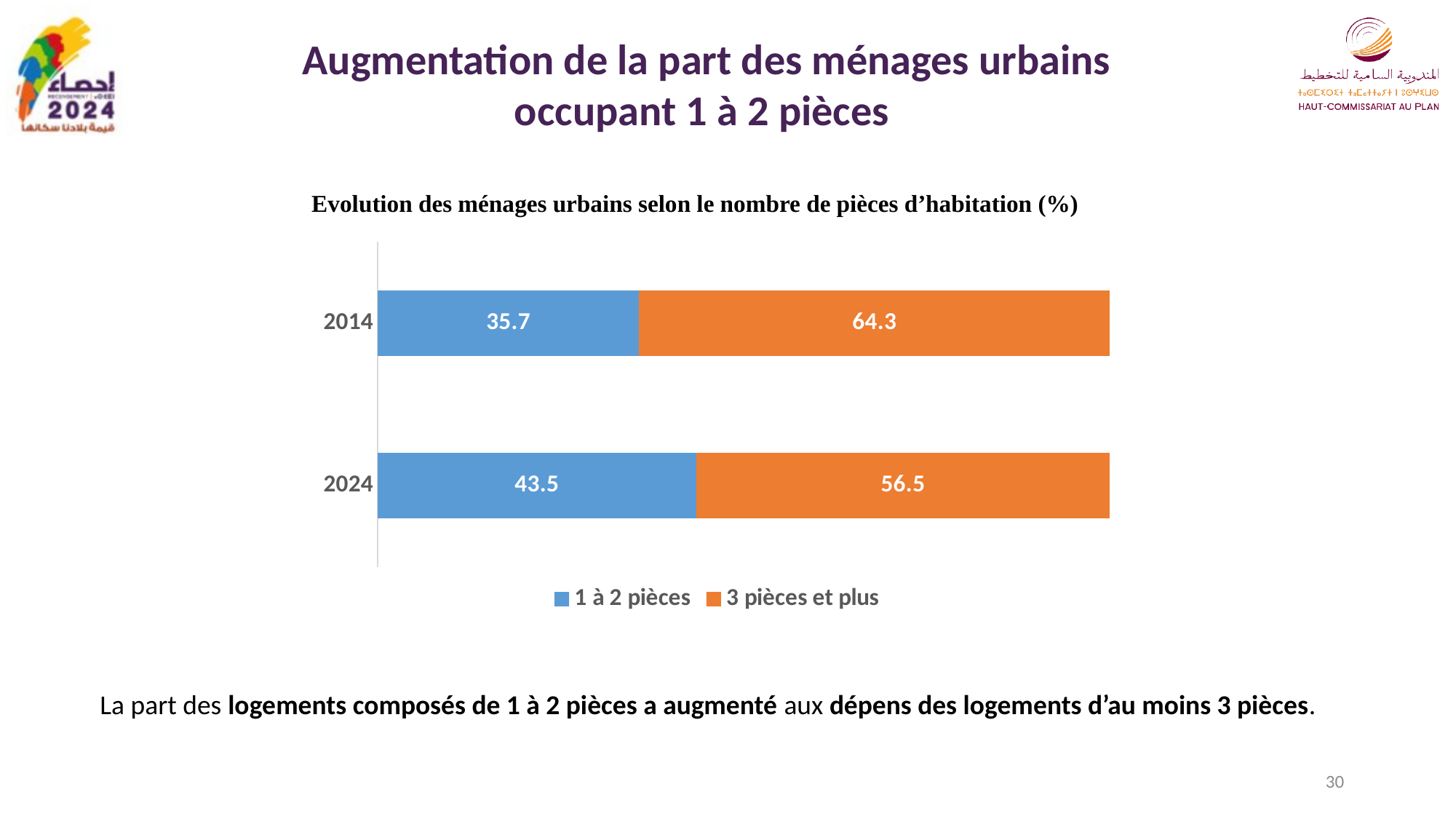
What kind of chart is shown on the slide? Stacked bar chart In which year is the value for '3 pièces et plus' higher, 2014 or 2024? 2014 What is the total of the stacked bar for 2024? 100 What is the value for '1 à 2 pièces' in 2014? 35.7 What is the value for '3 pièces et plus' in 2024? 56.5 How many series does the legend list? 2 Which series has the larger value in 2024, '1 à 2 pièces' or '3 pièces et plus'? 3 pièces et plus By how much did the share of '1 à 2 pièces' change between 2014 and 2024? 7.8 How many years (categories) are shown in the chart? 2 What is the value for '3 pièces et plus' in 2014? 64.3 What is the difference between '3 pièces et plus' and '1 à 2 pièces' in 2014? 28.6 What is the value for '1 à 2 pièces' in 2024? 43.5